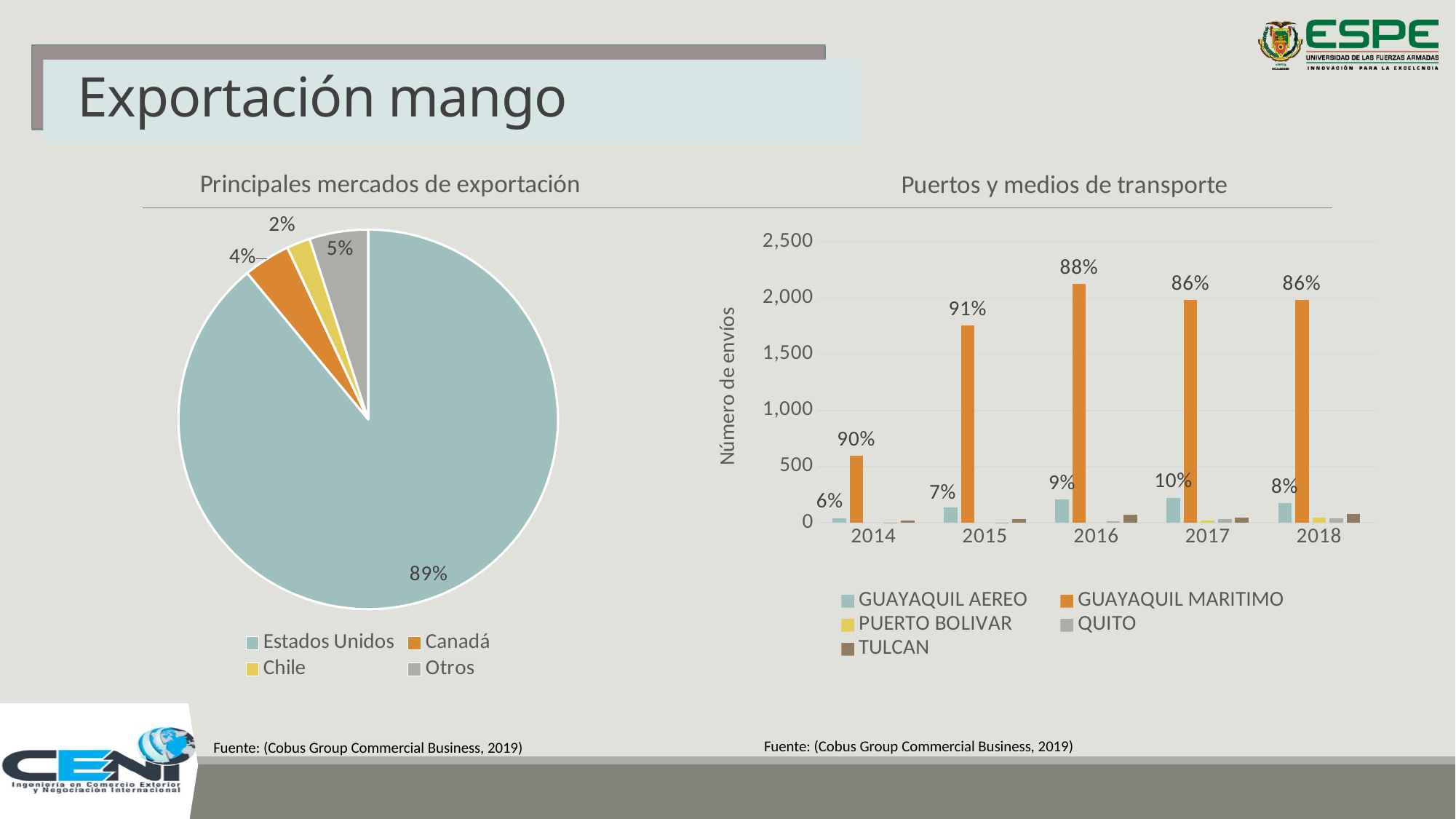
In the chart 'Puertos y medios de transporte', how many years are shown on the x axis? 5 In the chart 'Puertos y medios de transporte', what percentage label is shown for GUAYAQUIL AEREO in 2017? 10% In the chart 'Puertos y medios de transporte', how many series does the legend list? 5 In the pie chart 'Principales mercados de exportación', what share does Canadá have? 4% In the pie chart 'Principales mercados de exportación', which is larger, the share for Otros or the share for Canadá? Otros In the chart 'Puertos y medios de transporte', what percentage label is shown for GUAYAQUIL MARITIMO in 2016? 88% In the chart 'Puertos y medios de transporte', is the number of envíos for GUAYAQUIL MARITIMO in 2016 greater or less than 2,000? greater In the chart 'Puertos y medios de transporte', in which year is the GUAYAQUIL MARITIMO bar highest? 2016 In the pie chart 'Principales mercados de exportación', which market has the smallest share? Chile In the pie chart 'Principales mercados de exportación', what share does Estados Unidos have? 89% What kind of chart is 'Puertos y medios de transporte'? Bar chart In the pie chart 'Principales mercados de exportación', how many slices are there? 4